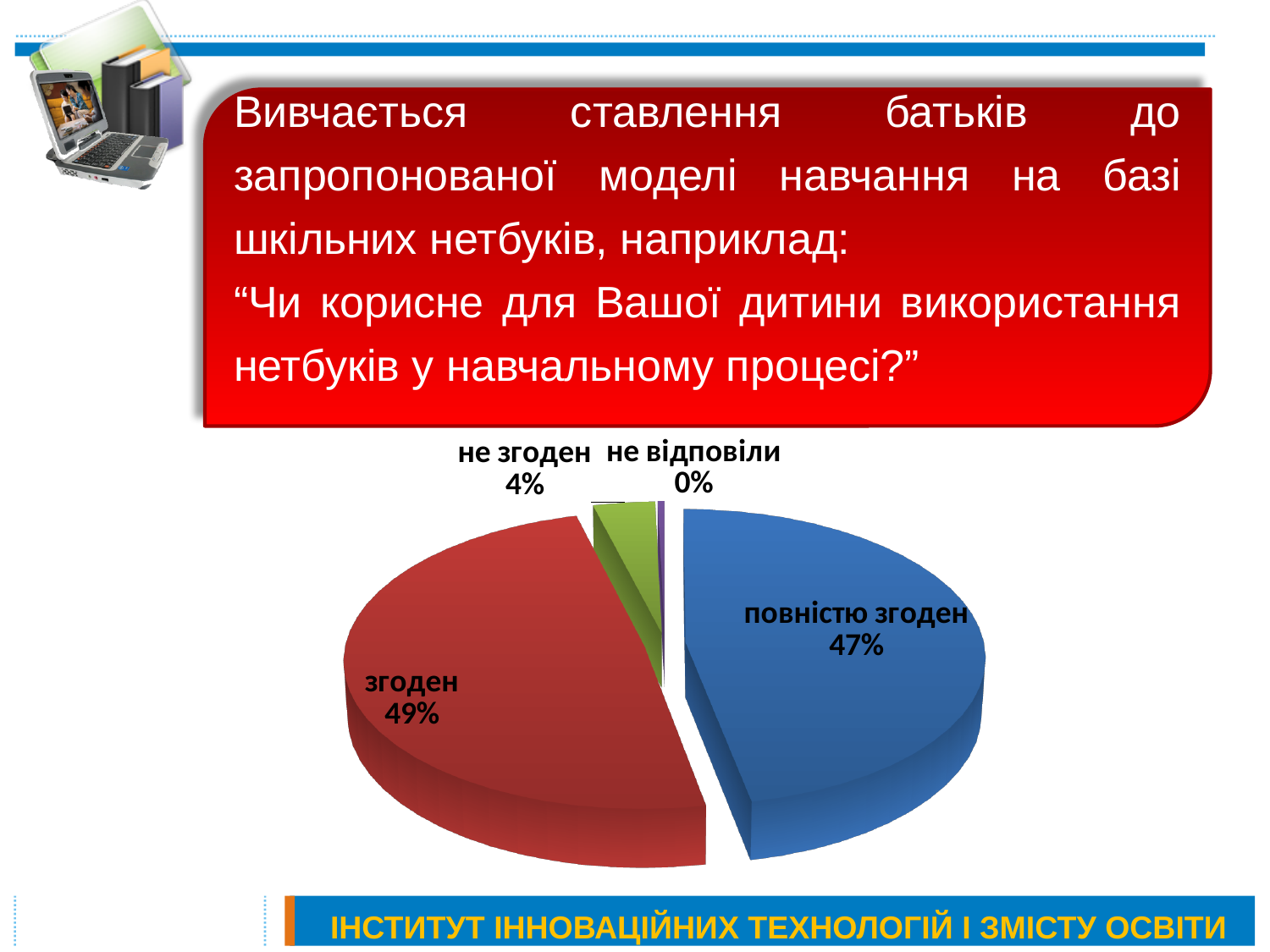
Which slice of the pie is the smallest? не відповіли What share of the pie does the slice "згоден" represent? 49% What is the value shown for "не відповіли"? 0% What is the difference between the shares for "згоден" and "повністю згоден"? 2% What kind of chart is shown on the slide? pie chart What is the value shown for "не згоден"? 4% What share of the pie does the slice "повністю згоден" represent? 47% Which slice of the pie is the largest? згоден How many slices does the pie chart have? 4 What is the combined share of "повністю згоден" and "згоден"? 96% Which is larger, the share for "повністю згоден" or the share for "не згоден"? повністю згоден What colour is the slice for "згоден"? red